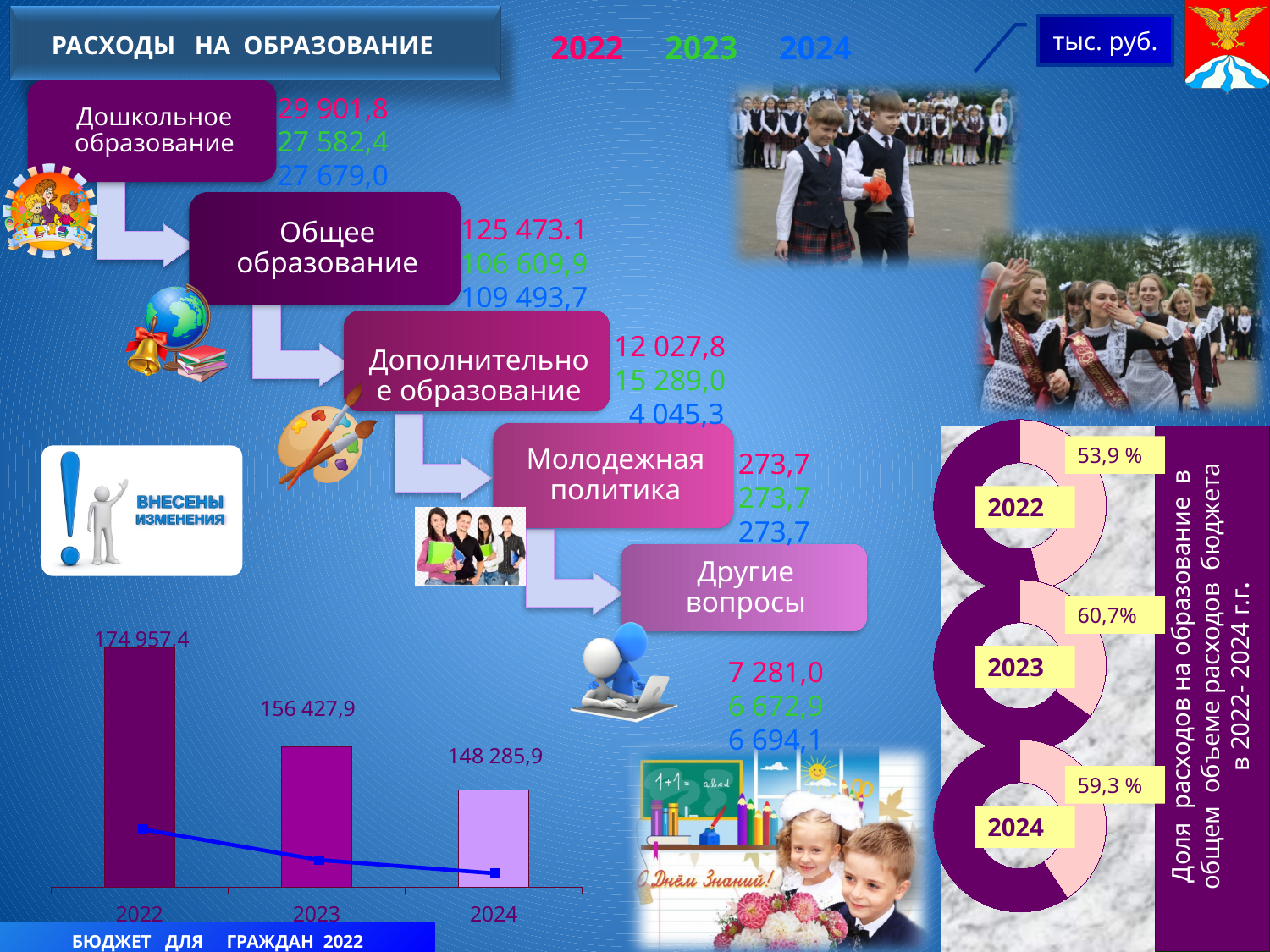
How many years are shown in the bar chart at the bottom left of the slide? 3 In the bar chart at the bottom left of the slide, do the values rise or fall from 2022 to 2024? fall In the bar chart at the bottom left of the slide, what is the difference between the values for 2022 and 2023? 18 529,5 In the bar chart at the bottom left of the slide, which is larger: the value for 2023 or the value for 2024? 2023 In the bar chart at the bottom left of the slide, what is the value for 2024? 148 285,9 In the bar chart at the bottom left of the slide, which year has the lowest value? 2024 In the bar chart at the bottom left of the slide, what is the value for 2022? 174 957,4 In the bar chart at the bottom left of the slide, which year has the highest value? 2022 In the bar chart at the bottom left of the slide, what is the value for 2023? 156 427,9 In the bar chart at the bottom left of the slide, what is the difference between the values for 2023 and 2024? 8 142,0 In the donut charts on the right of the slide (Доля расходов на образование в общем объеме расходов бюджета), which year has the highest share? 2023 In the donut charts on the right of the slide (Доля расходов на образование в общем объеме расходов бюджета), what is the share for 2023? 60,7%